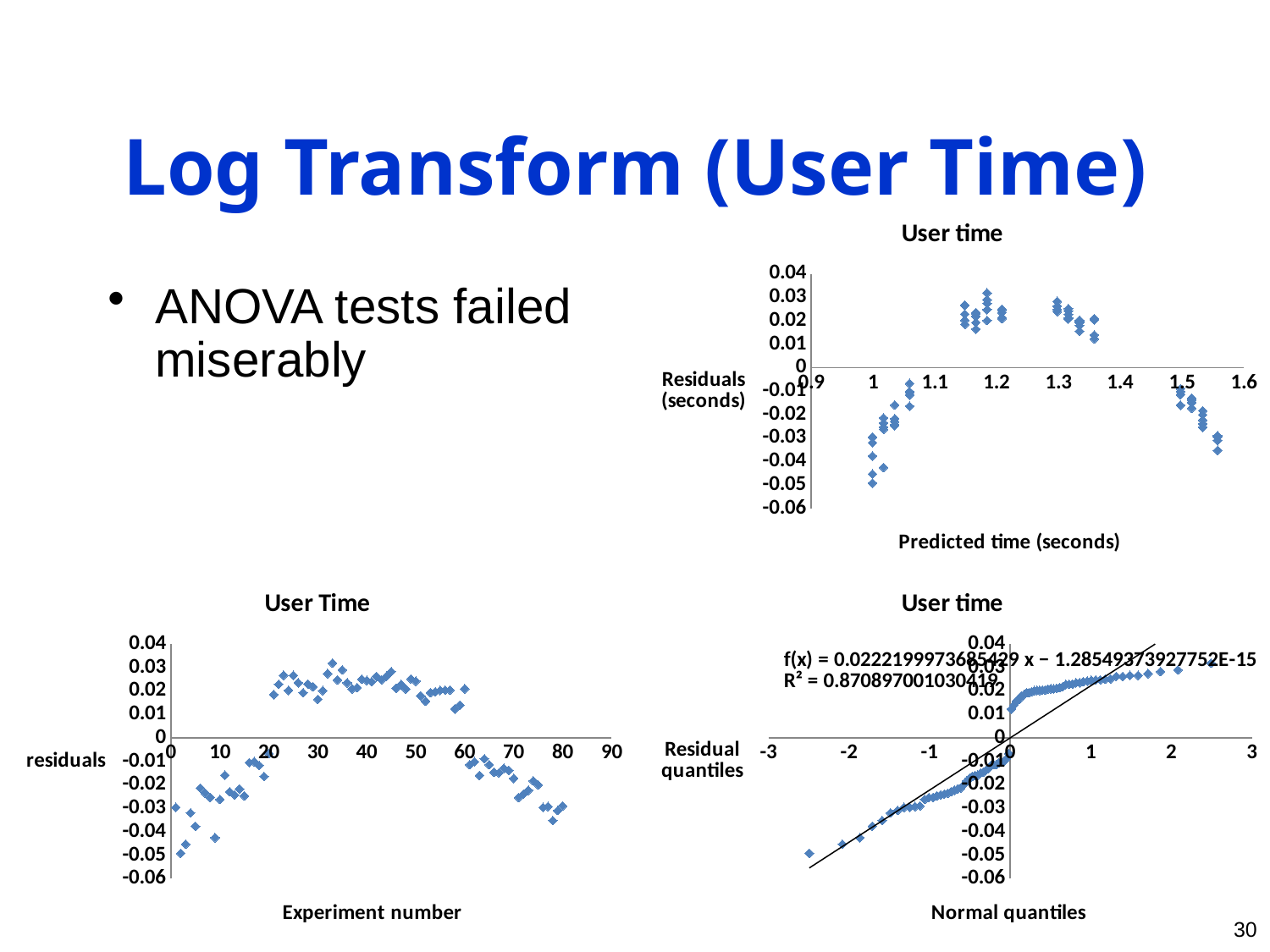
In the top-right chart, are the residuals at a predicted time of 1.5 seconds greater or less than 0? less In the bottom-right chart, is the residual quantile at a normal quantile of 2 greater or less than 0? greater In the bottom-right chart, is the residual quantile at a normal quantile of -2 greater or less than 0? less In the bottom-right chart, what is the slope of the fitted line f(x)? 0.0222199973685429 In the top-right chart, what is the x-axis title? Predicted time (seconds) In the bottom-left chart titled "User Time", what is the x-axis title? Experiment number How many charts are shown on the slide? 3 What kind of chart is the top-right chart titled "User time"? scatter chart In the bottom-right chart, what is the R² value shown for the fitted line? 0.870897001030419 In the bottom-right chart, do the residual quantiles rise or fall as the normal quantiles increase from -3 to 3? rise